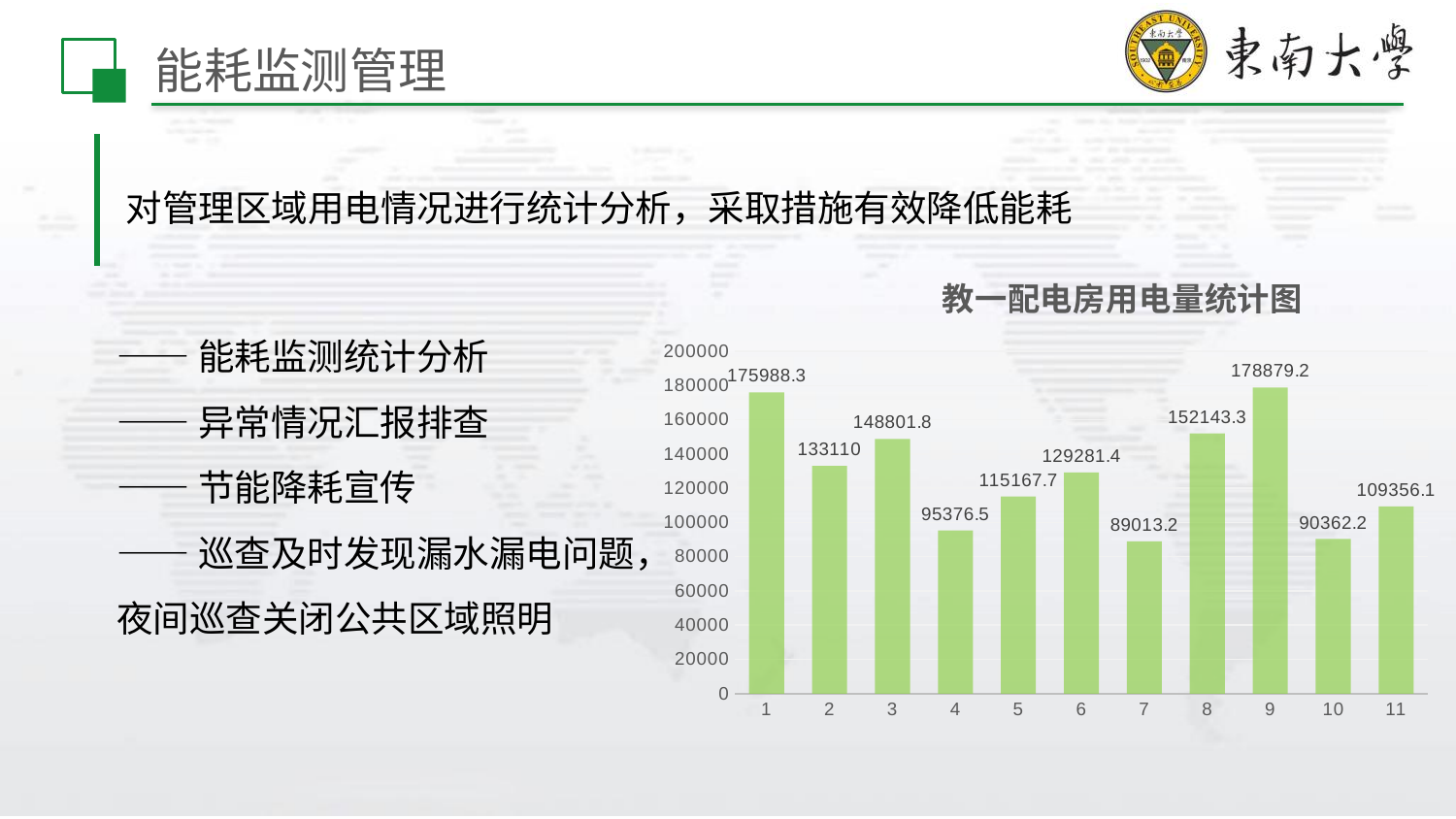
What is the value for category 11 in the chart? 109356.1 What is the value for category 7 in the chart? 89013.2 Is the value for category 4 greater or less than 100000? less What is the title of the chart? 教一配电房用电量统计图 What is the difference between the values for category 1 and category 2? 42878.3 Which category has the lowest value in the chart? 7 What is the difference between the values for category 8 and category 7? 63130.1 How many categories are shown on the x axis of the chart? 11 Which is larger, the value for category 3 or the value for category 6? category 3 What is the value for category 1 in the chart? 175988.3 What kind of chart is shown on the slide? bar chart Which category has the highest value in the chart? 9